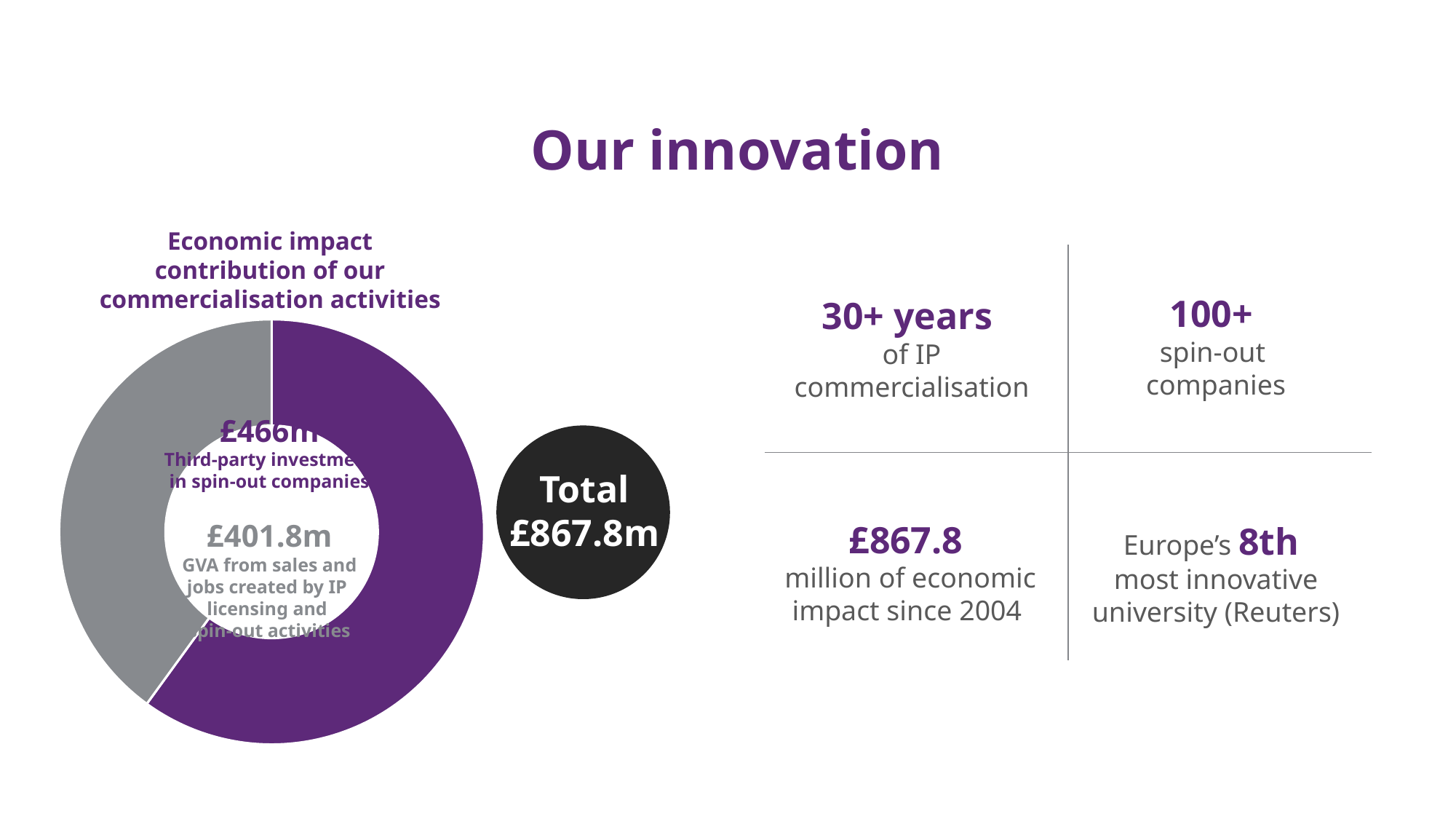
What is the value for third-party investment in spin-out companies? £466m What colour is the segment representing third-party investment in spin-out companies? Purple Which is larger: third-party investment in spin-out companies or GVA from IP licensing and spin-out activities? Third-party investment in spin-out companies Which segment of the chart is the smallest? GVA from sales and jobs created by IP licensing and spin-out activities What kind of chart is shown on the slide? Pie chart (donut) What is the title of the chart on the slide? Economic impact contribution of our commercialisation activities What is the total economic impact contribution shown next to the chart? £867.8m Which segment of the chart is the largest? Third-party investment in spin-out companies What is the difference between the third-party investment value and the GVA value? £64.2m What is the value for GVA from sales and jobs created by IP licensing and spin-out activities? £401.8m How many segments does the donut chart have? 2